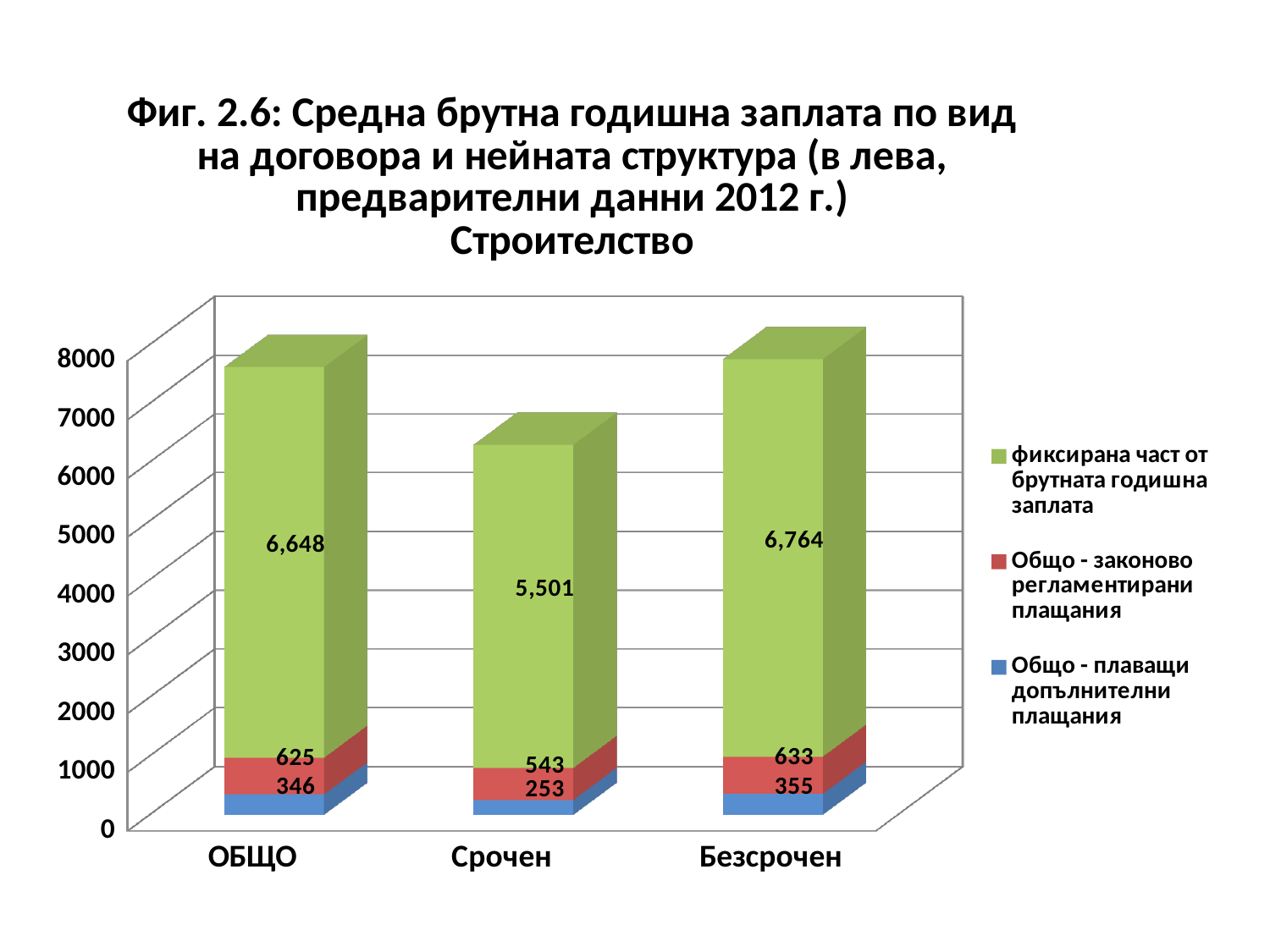
Which colour represents фиксирана част от брутната годишна заплата in the chart? Green Which category has the lowest value for Общо - плаващи допълнителни плащания? Срочен What is the value of Общо - законово регламентирани плащания for Безсрочен? 633 What kind of chart is shown on the slide? Stacked bar chart Which is larger: Общо - законово регламентирани плащания for ОБЩО or for Срочен? ОБЩО Which category has the highest value for фиксирана част от брутната годишна заплата? Безсрочен What is the value of the fixed part of gross annual salary (фиксирана част от брутната годишна заплата) for Срочен? 5,501 What is the value of Общо - плаващи допълнителни плащания for ОБЩО? 346 How many series does the legend list? 3 What is the difference between the fixed part of gross annual salary for Безсрочен and for Срочен? 1,263 What is the total of the stacked bar for Срочен? 6,297 How many categories are shown on the x axis? 3